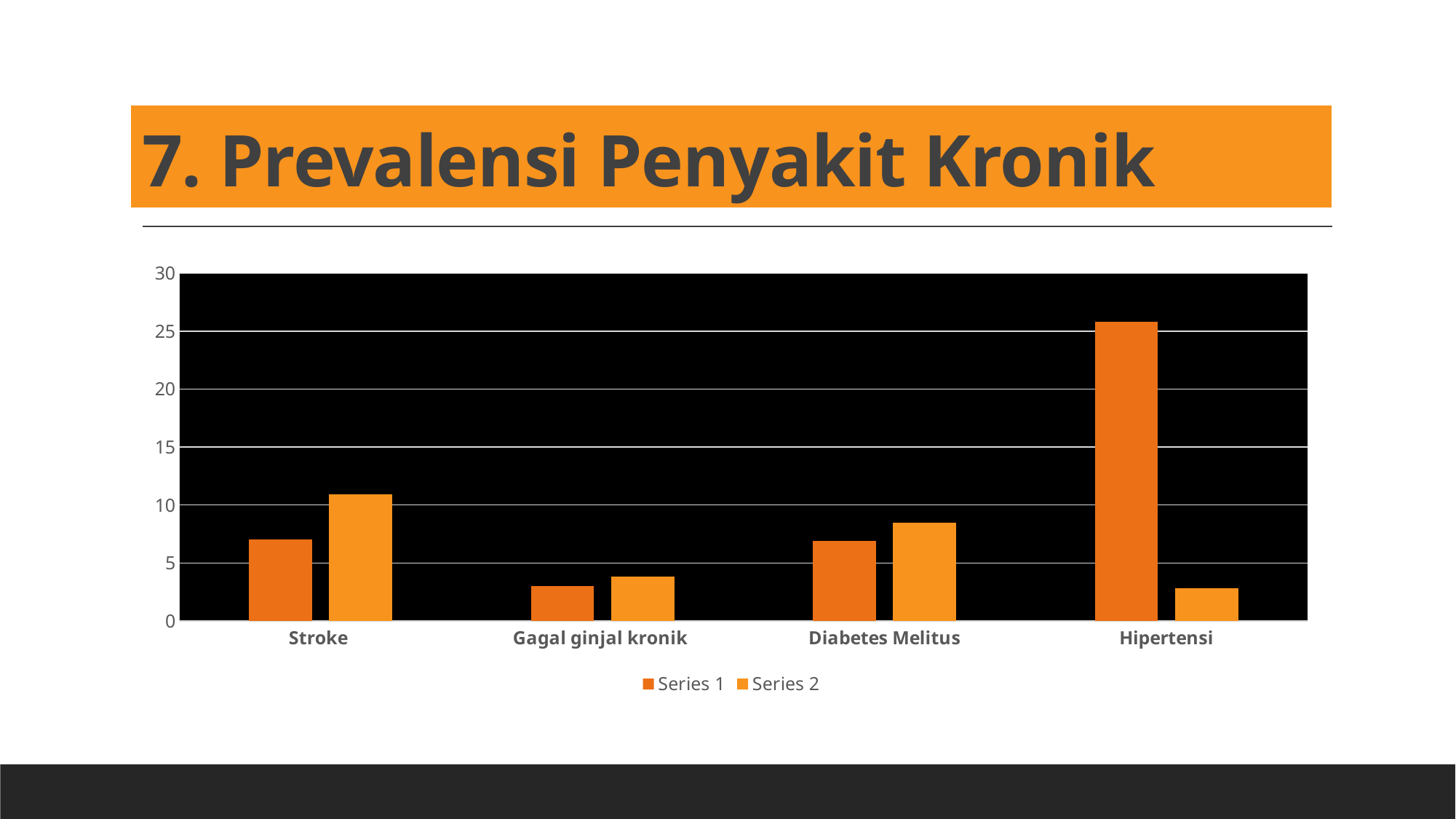
Which category has the highest Series 1 value? Hipertensi Is the Series 1 value for Hipertensi greater or less than 20? greater For Hipertensi, which is larger: Series 1 or Series 2? Series 1 What is the title of the slide containing the chart? 7. Prevalensi Penyakit Kronik Is the Series 1 value for Gagal ginjal kronik greater or less than 5? less Is the Series 2 value for Diabetes Melitus greater or less than 10? less How many series does the legend list? 2 For Stroke, which is larger: Series 1 or Series 2? Series 2 How many categories are shown on the x axis of the chart? 4 What kind of chart is shown on the slide? bar chart Which category has the lowest Series 1 value? Gagal ginjal kronik Which category has the highest Series 2 value? Stroke